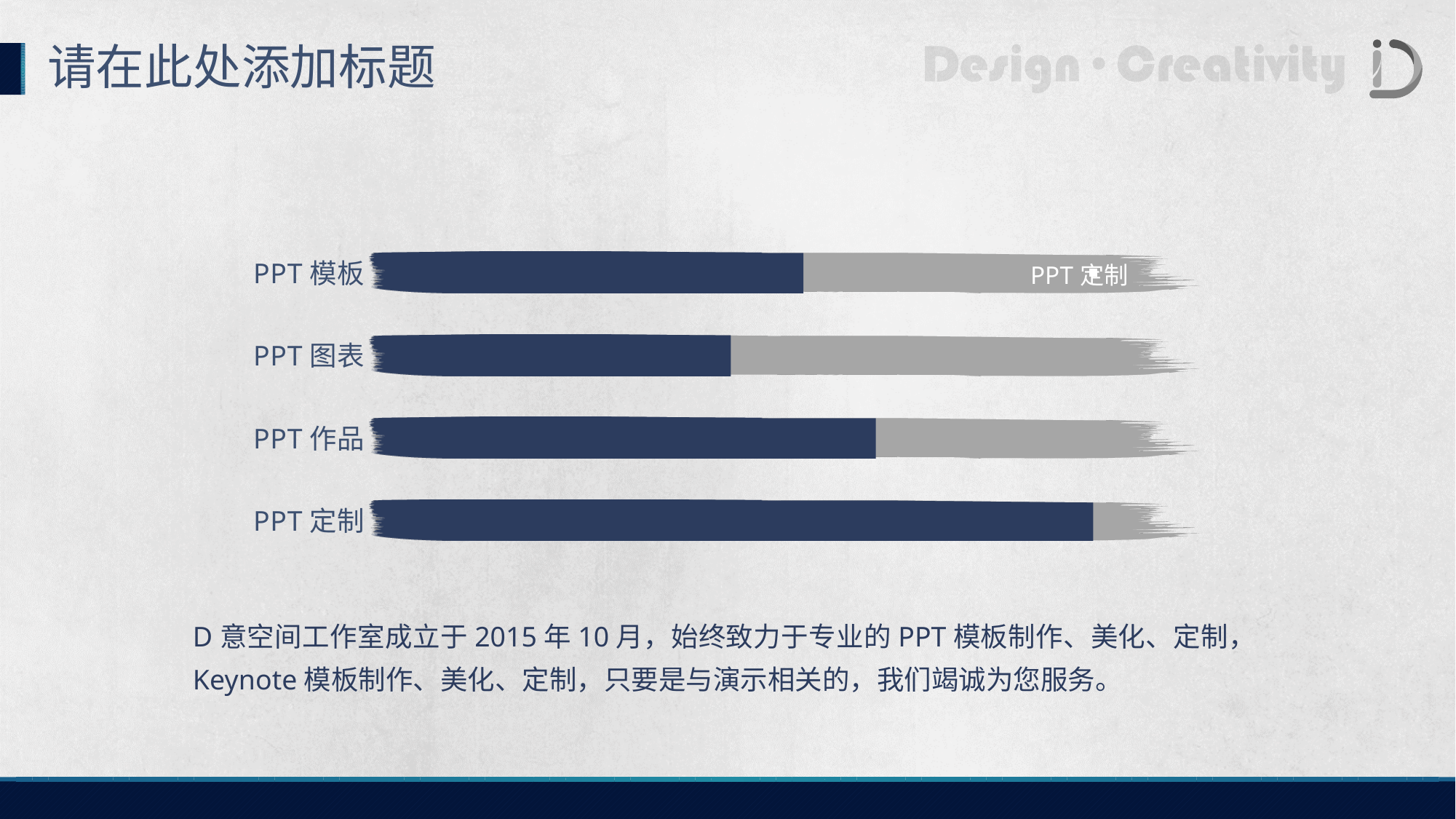
Which has the longer dark blue bar, PPT 定制 or PPT 作品? PPT 定制 Are the bars in the chart oriented horizontally or vertically? horizontally Which category has the longest dark blue bar? PPT 定制 Which has the longer dark blue bar, PPT 模板 or PPT 图表? PPT 模板 Which category has the shortest dark blue bar? PPT 图表 Which has the longer dark blue bar, PPT 定制 or PPT 图表? PPT 定制 What kind of chart is shown on the slide? bar chart How many categories does the bar chart show? 4 What is the label of the category listed at the top of the bar chart? PPT 模板